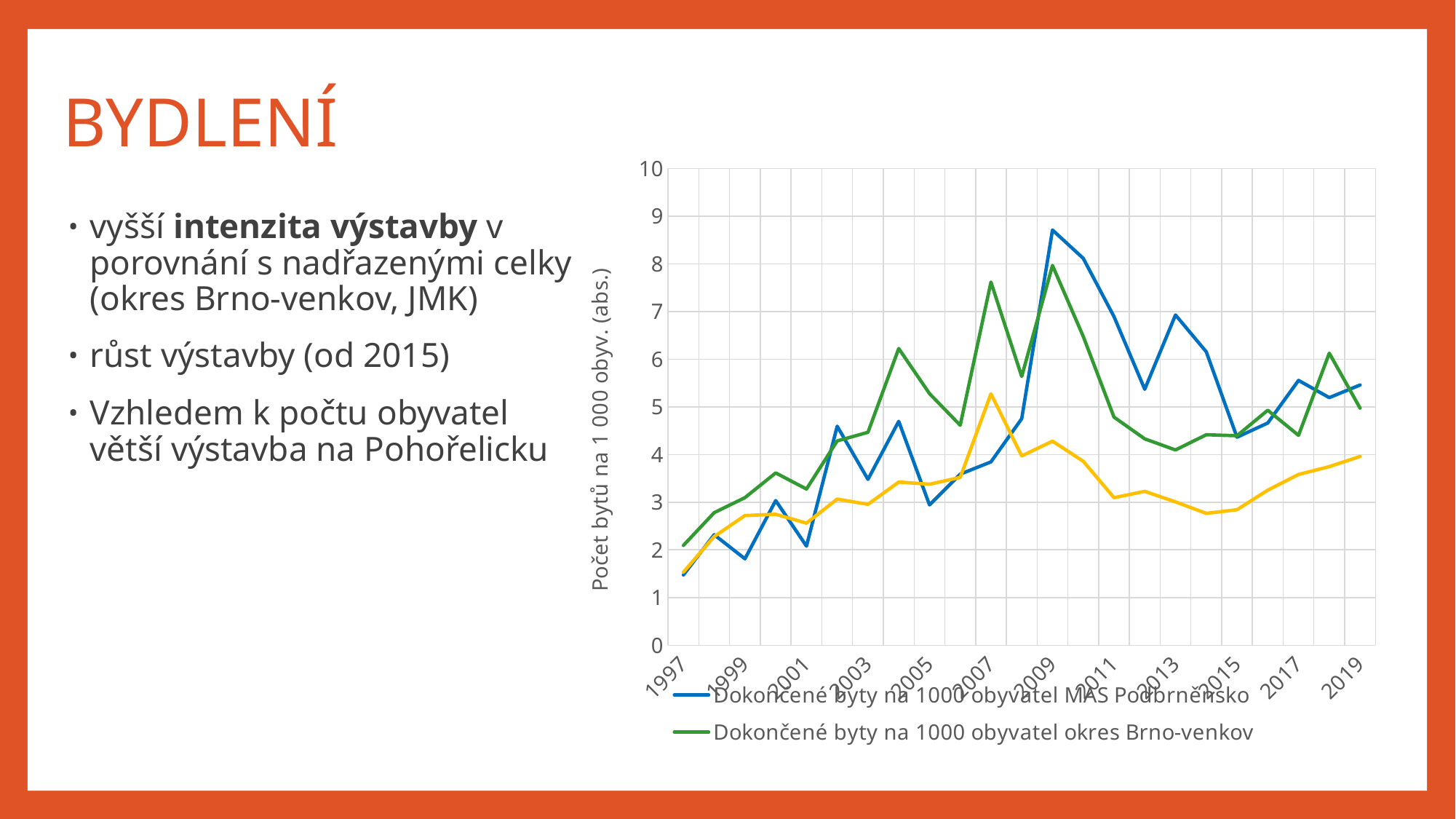
How many series does the chart legend list? 2 In which year does the series 'Dokončené byty na 1000 obyvatel MAS Podbrněnsko' reach its highest value? 2009 Is the 2013 value for 'Dokončené byty na 1000 obyvatel okres Brno-venkov' greater or less than 5? less What is the title of the vertical axis of the chart? Počet bytů na 1 000 obyv. (abs.) In which year does the series 'Dokončené byty na 1000 obyvatel okres Brno-venkov' reach its highest value? 2009 In 2009, which series is higher: 'Dokončené byty na 1000 obyvatel MAS Podbrněnsko' or 'Dokončené byty na 1000 obyvatel okres Brno-venkov'? Dokončené byty na 1000 obyvatel MAS Podbrněnsko Is the 1997 value for 'Dokončené byty na 1000 obyvatel MAS Podbrněnsko' greater or less than 2? less What kind of chart is shown on the slide? line chart In 2004, which series is higher: 'Dokončené byty na 1000 obyvatel MAS Podbrněnsko' or 'Dokončené byty na 1000 obyvatel okres Brno-venkov'? Dokončené byty na 1000 obyvatel okres Brno-venkov Is the 2009 value for 'Dokončené byty na 1000 obyvatel MAS Podbrněnsko' greater or less than 8? greater Does the series 'Dokončené byty na 1000 obyvatel MAS Podbrněnsko' rise or fall between 2009 and 2012? fall How many year labels are shown on the x axis of the chart? 12